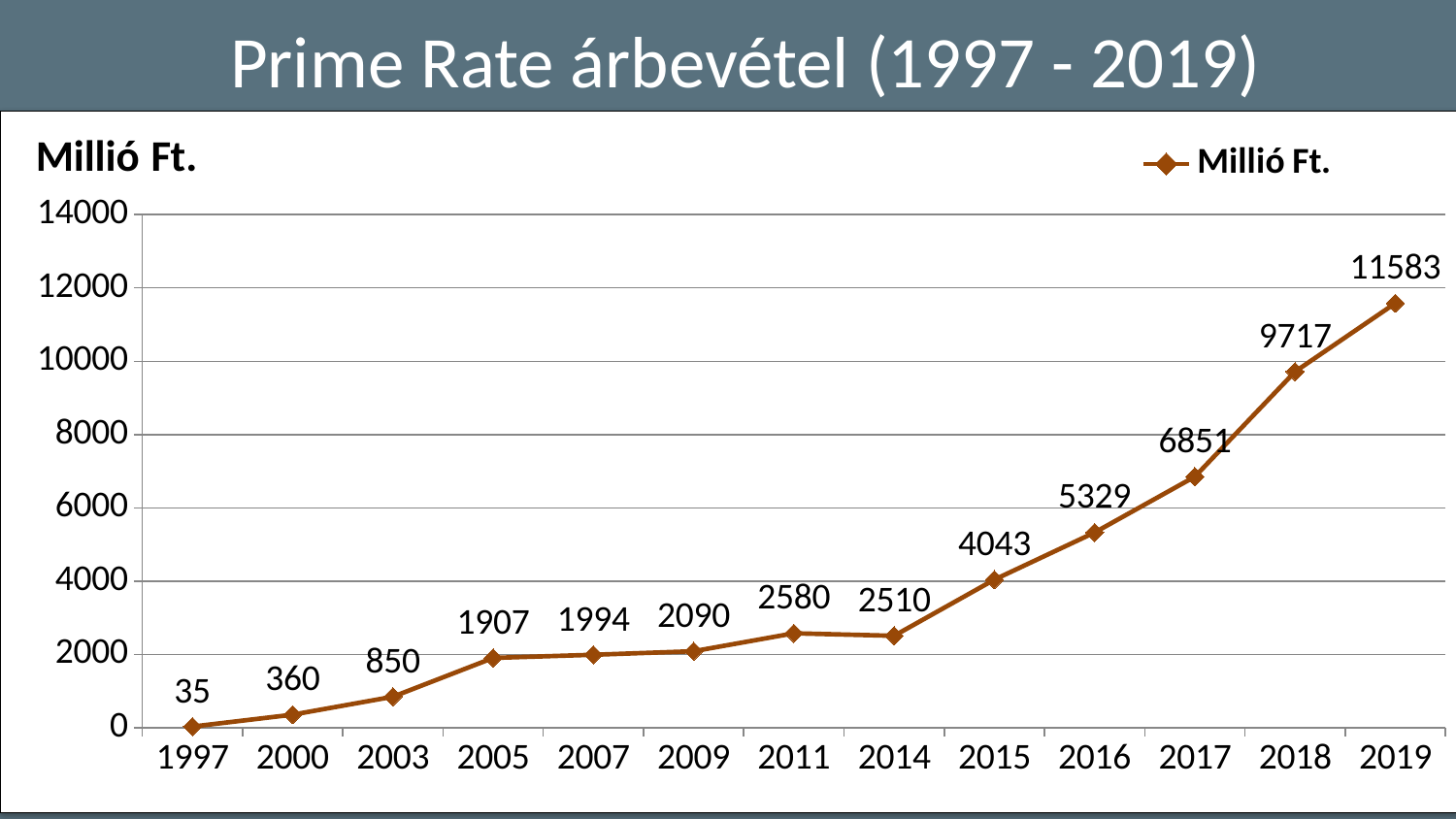
What is the value for 2005? 1907 What is the value for 2017? 6851 What is the difference between the values for 2019 and 2018? 1866 Which year has the highest value? 2019 What is the title of the chart? Prime Rate árbevétel (1997 - 2019) Which is larger, the value for 2011 or the value for 2014? 2011 What is the value for 1997? 35 What is the difference between the values for 2011 and 2014? 70 How many years are plotted on the chart? 13 How many series does the legend list? 1 Which year has the lowest value? 1997 What kind of chart is this? line chart